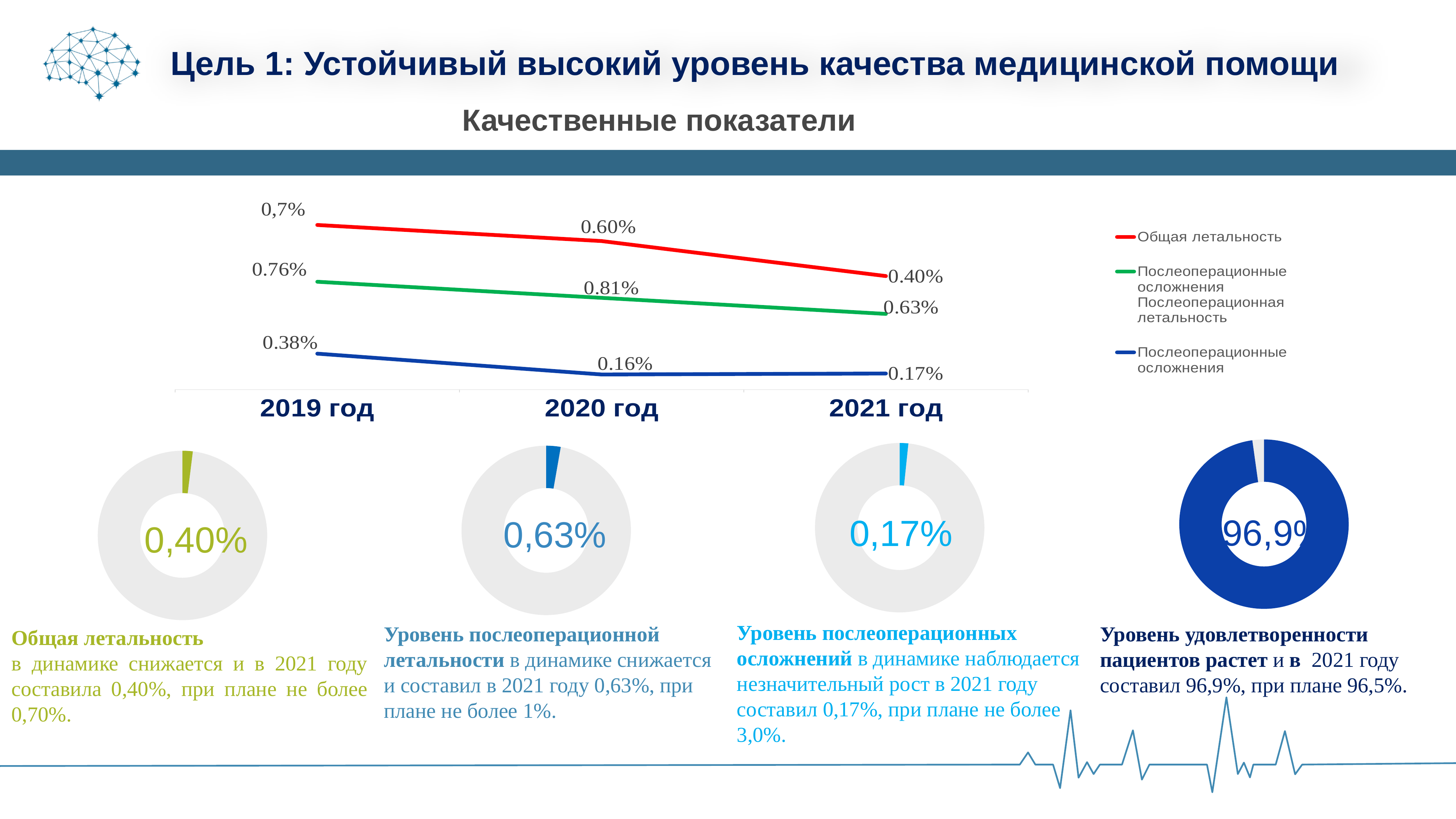
How many years are shown on the x axis of the line chart? 3 On the line chart, in which year does the blue line have its lowest value? 2020 год On the line chart, does the red line (Общая летальность) rise or fall from 2019 год to 2021 год? fall On the line chart, what is the difference between the blue line's values for 2019 год and 2020 год? 0.22% On the line chart, what is the value of the green line for 2020 год? 0.81% What value is shown in the centre of the rightmost donut chart (Уровень удовлетворенности пациентов)? 96,9% On the line chart, what is the value of the blue line for 2019 год? 0.38% What kind of chart is the chart at the top of the slide with the years 2019, 2020 and 2021? line chart On the line chart, what is the value of the red line (Общая летальность) for 2021 год? 0.40% What value is shown in the centre of the leftmost donut chart (Общая летальность)? 0,40% On the line chart, in which year does the green line reach its highest value? 2020 год On the line chart, what is the value of the red line (Общая летальность) for 2019 год? 0,7%